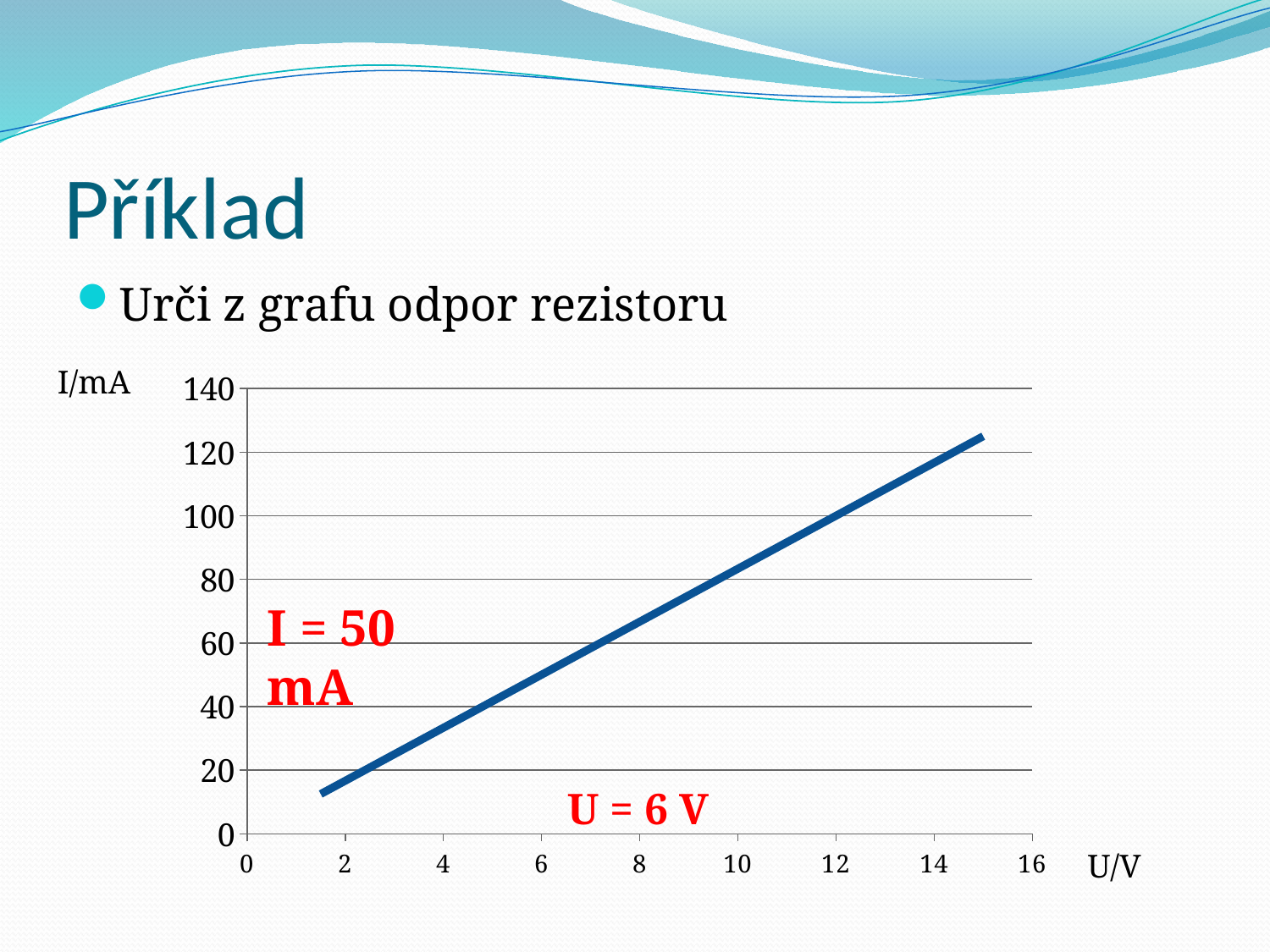
What is the highest value shown on the horizontal axis? 16 Does the current I rise or fall as the voltage U increases along the x axis? rises What kind of chart is shown on the slide? line chart What is the label of the vertical axis of the chart? I/mA According to the red annotation on the chart, at what voltage is the current 50 mA? 6 V What is the label of the horizontal axis of the chart? U/V Is the current at U = 2 V greater or less than 20? less Is the current at U = 10 V greater or less than 60? greater Is the current at U = 14 V greater or less than 100? greater What is the highest value shown on the vertical axis? 140 According to the red annotation on the chart, what current corresponds to U = 6 V? 50 mA